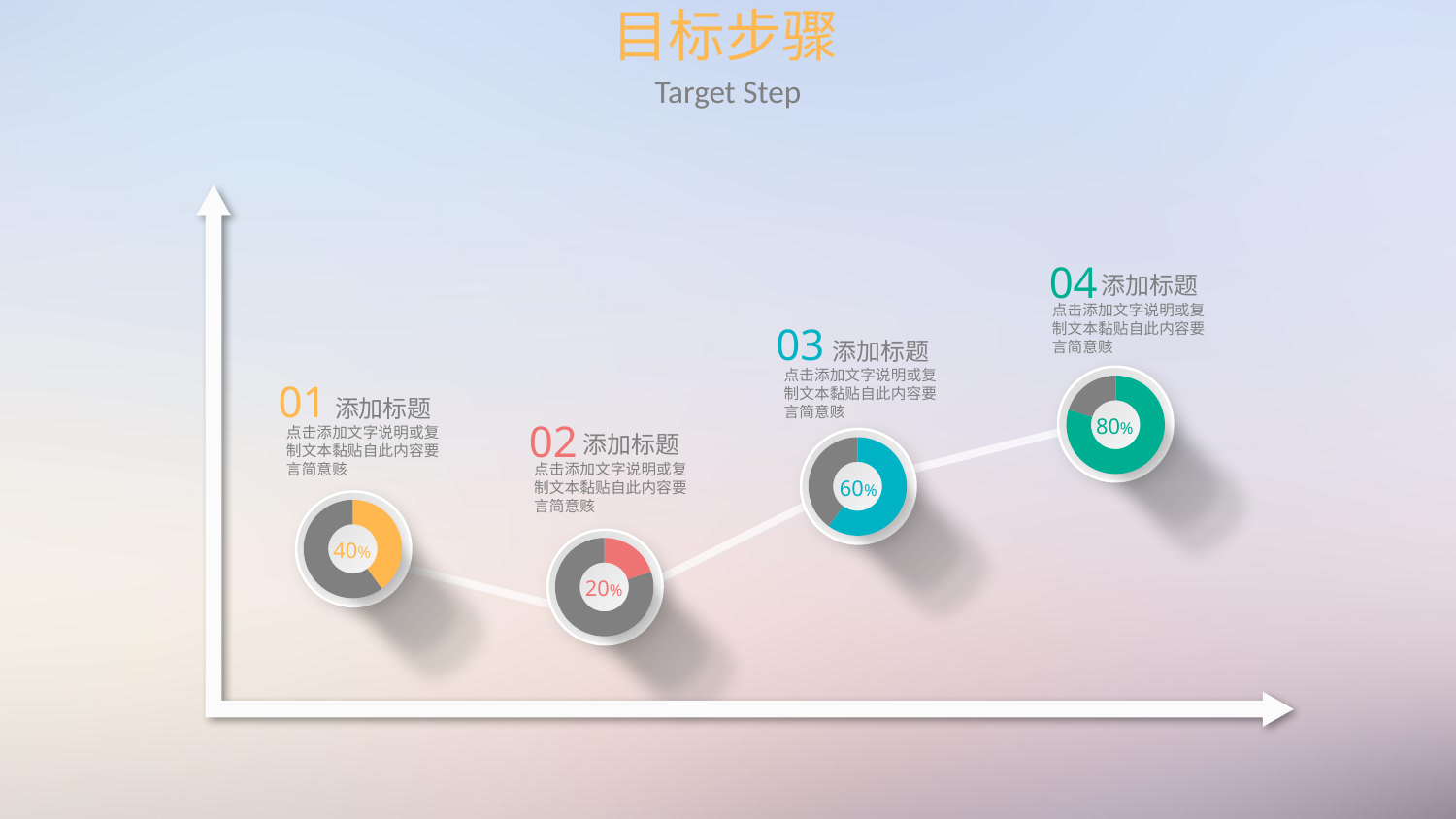
What percentage is shown in the donut chart for step 03? 60% Which is larger, the percentage for step 01 or the percentage for step 02? step 01 What percentage is shown in the donut chart for step 01? 40% What is the difference between the percentages for step 03 and step 01? 20% What colour is the filled portion of the donut chart for step 03? blue What percentage is shown in the donut chart for step 02? 20% What kind of charts are used to show the percentages for each step? donut charts What is the difference between the percentages for step 04 and step 02? 60% Which step has the highest percentage in its donut chart? 04 What percentage is shown in the donut chart for step 04? 80% Which step has the lowest percentage in its donut chart? 02 How many donut charts are shown on the slide? 4